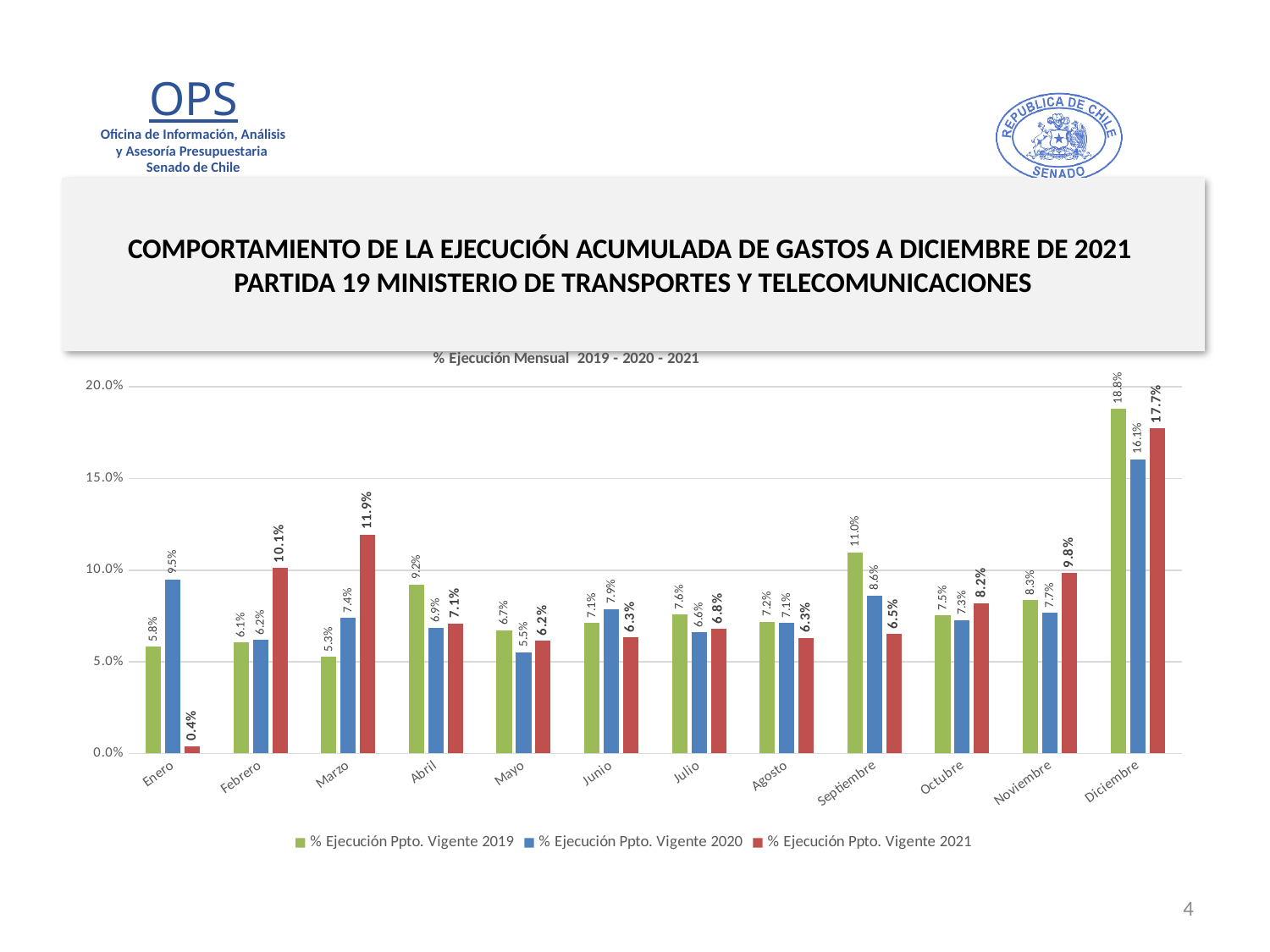
What type of chart is shown on the slide? bar chart Which month has the highest value for % Ejecución Ppto. Vigente 2021? Diciembre What is the difference between the 2021 and 2019 values in Marzo? 6.6% In Enero, which series has the larger value: 2019 or 2020? 2020 Is the value for % Ejecución Ppto. Vigente 2019 in Diciembre greater or less than 15.0%? greater How many series does the legend list? 3 What is the value for % Ejecución Ppto. Vigente 2019 in Septiembre? 11.0% Which month has the lowest value for % Ejecución Ppto. Vigente 2019? Marzo What is the value for % Ejecución Ppto. Vigente 2021 in Enero? 0.4% What is the value for % Ejecución Ppto. Vigente 2020 in Diciembre? 16.1% How many months are shown on the x axis? 12 What is the title of the chart? % Ejecución Mensual 2019 - 2020 - 2021